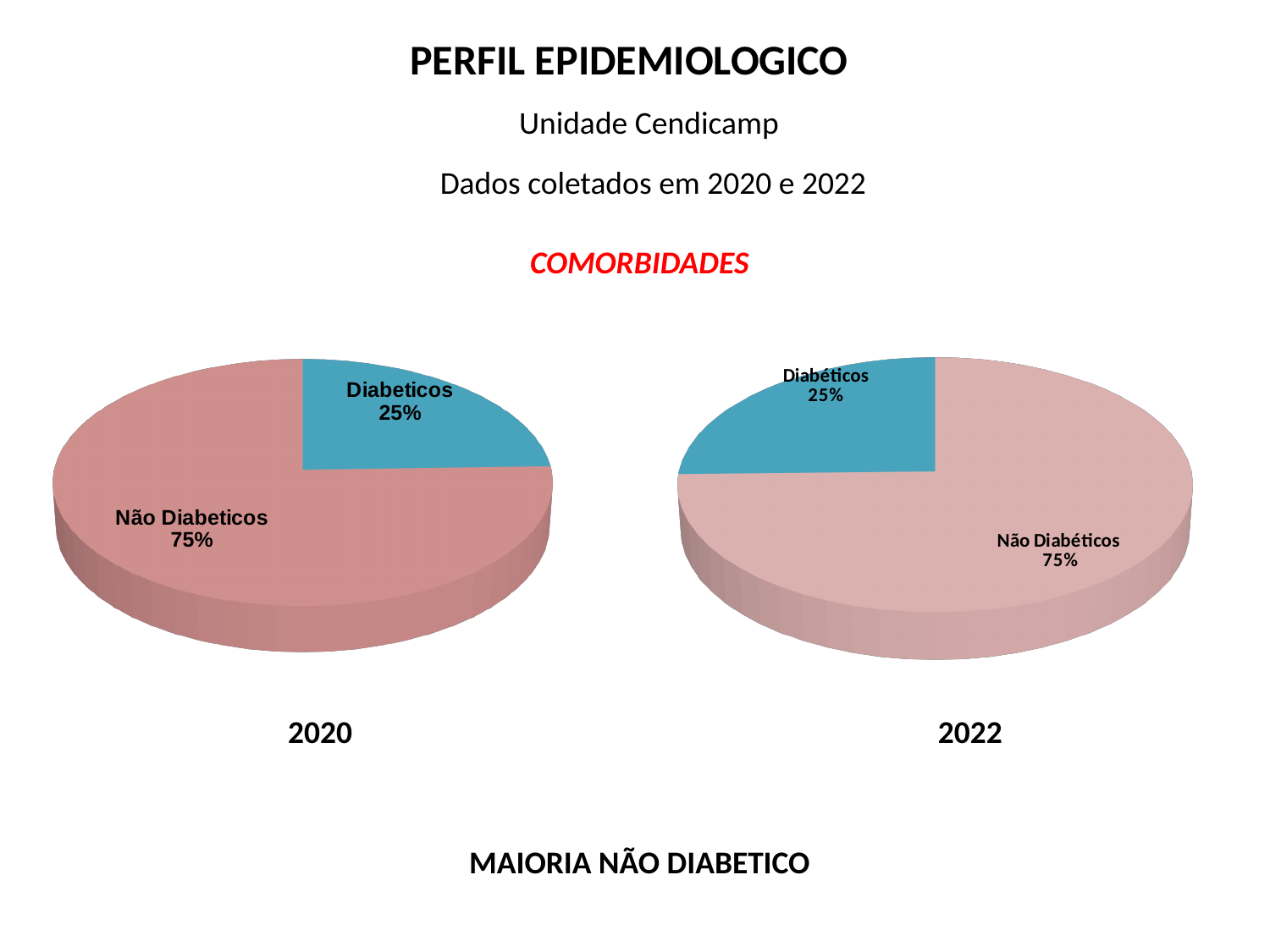
In the 2022 pie chart (right), what share is labelled for Diabéticos? 25% In the 2020 pie chart (left), what share is labelled for Não Diabeticos? 75% In the 2020 pie chart (left), what share is labelled for Diabeticos? 25% Did the share of Diabéticos change between the 2020 chart and the 2022 chart? No, it stayed at 25% What type of chart is the 2022 chart (right)? Pie chart In the 2022 pie chart (right), which is larger: Diabéticos or Não Diabéticos? Não Diabéticos In the 2022 pie chart (right), what share is labelled for Não Diabéticos? 75% What colour is the Diabeticos slice in the 2020 pie chart (left)? Blue How many slices does the 2020 pie chart (left) have? 2 In the 2022 pie chart (right), which slice is the smallest? Diabéticos In the 2020 pie chart (left), which slice is the largest? Não Diabeticos In the 2020 pie chart (left), what is the difference in percentage points between Não Diabeticos and Diabeticos? 50 percentage points